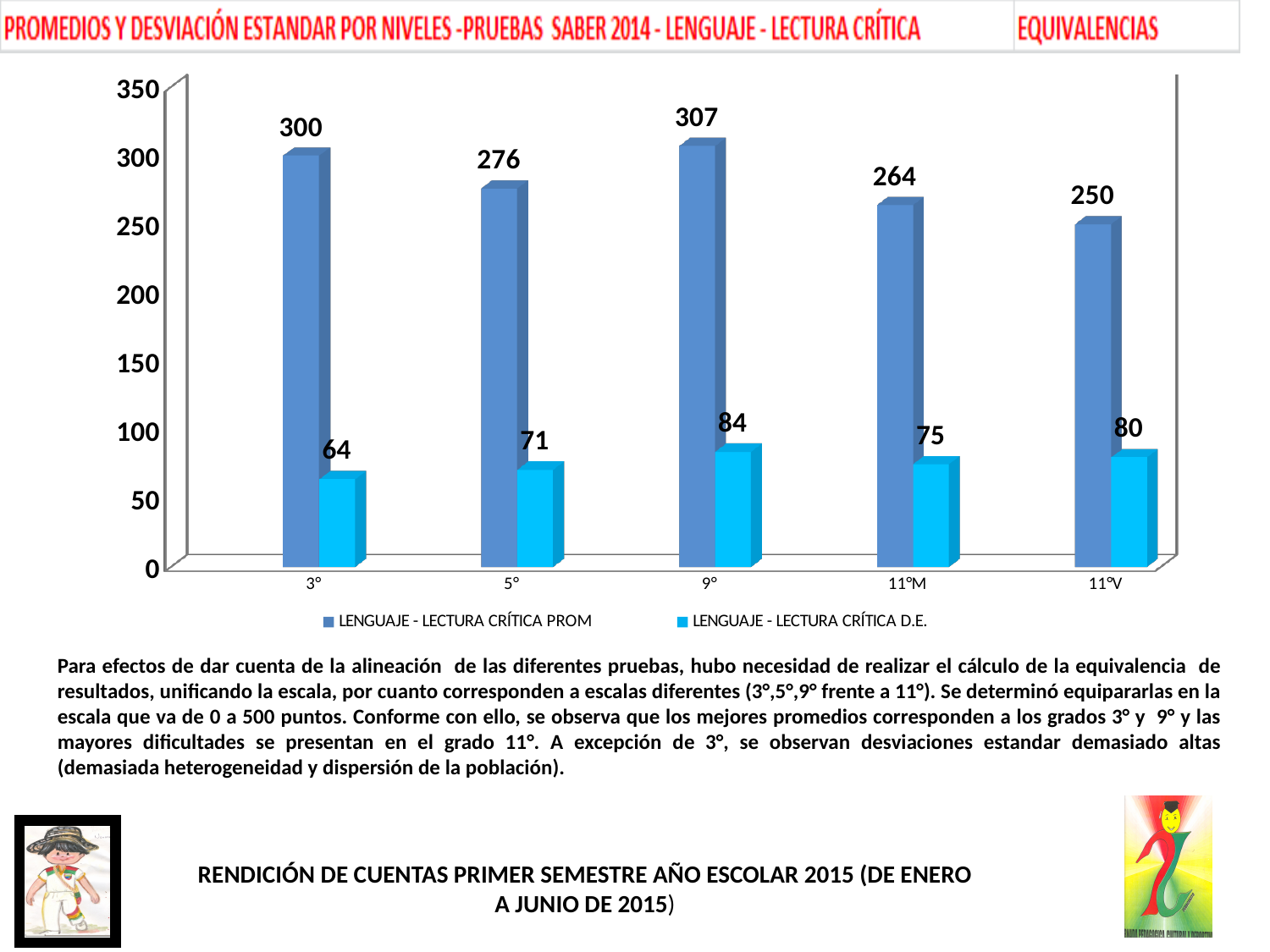
What kind of chart is shown on the slide? bar chart How many series does the legend list? 2 Which category has the highest LENGUAJE - LECTURA CRÍTICA PROM value? 9° What is the difference between the LENGUAJE - LECTURA CRÍTICA D.E. values for 9° and 5°? 13 Which category has the lowest LENGUAJE - LECTURA CRÍTICA D.E. value? 3° What is the LENGUAJE - LECTURA CRÍTICA PROM value for 9°? 307 What is the LENGUAJE - LECTURA CRÍTICA D.E. value for 3°? 64 How many categories are shown on the x axis? 5 Is the LENGUAJE - LECTURA CRÍTICA PROM value for 11°M greater or less than 250? greater What is the difference between the LENGUAJE - LECTURA CRÍTICA PROM values for 3° and 5°? 24 Which is larger, the LENGUAJE - LECTURA CRÍTICA D.E. value for 11°M or for 11°V? 11°V What is the LENGUAJE - LECTURA CRÍTICA PROM value for 11°V? 250